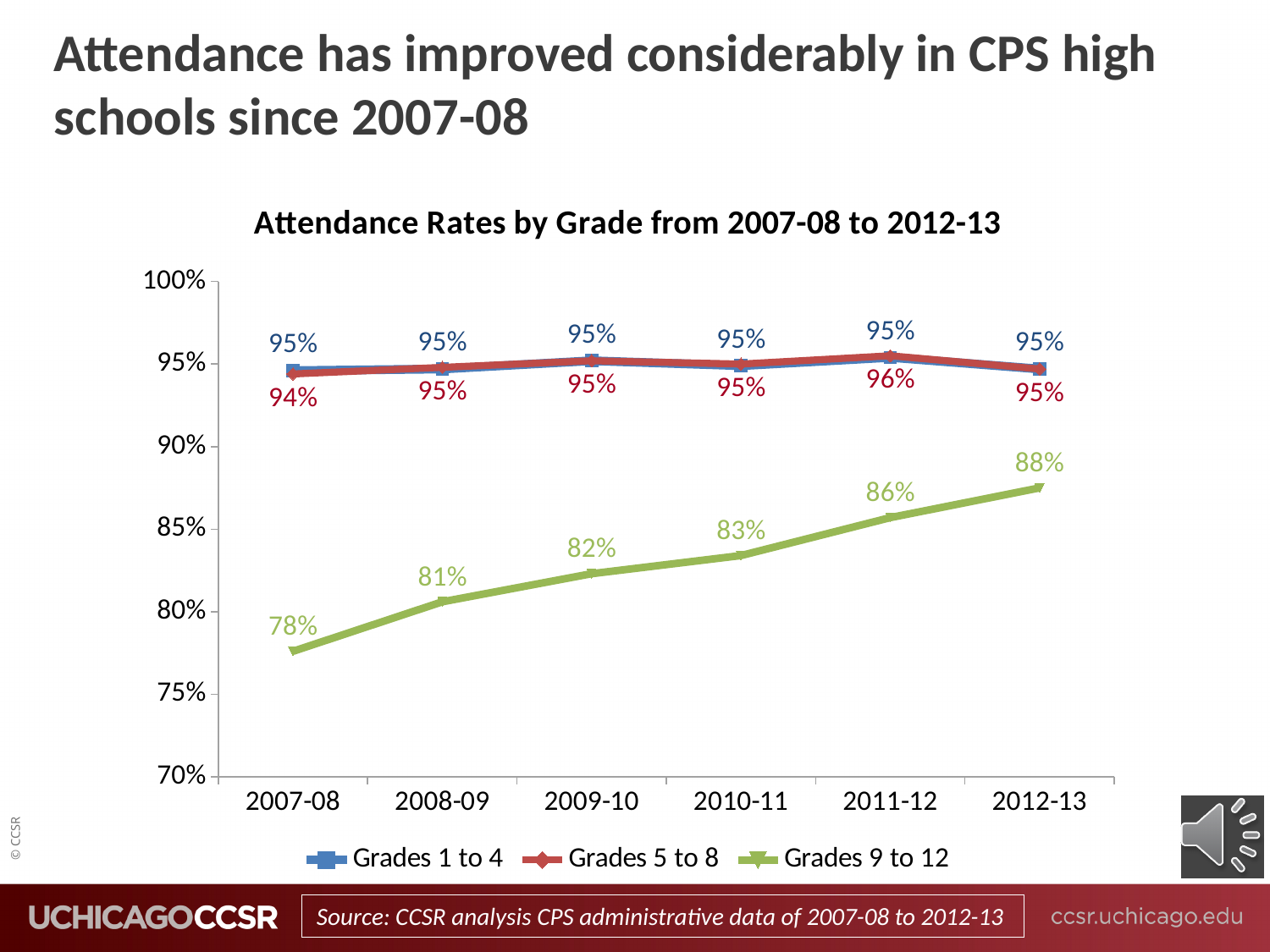
How many series does the legend list? 3 What is the attendance rate for Grades 9 to 12 in 2007-08? 78% Is the attendance rate for Grades 9 to 12 in 2008-09 greater or less than 85%? less In which year is the attendance rate for Grades 9 to 12 highest? 2012-13 How many school years are shown on the x axis? 6 In which year is the attendance rate for Grades 9 to 12 lowest? 2007-08 Which series has the higher attendance rate in 2009-10: Grades 1 to 4 or Grades 9 to 12? Grades 1 to 4 What is the attendance rate for Grades 9 to 12 in 2012-13? 88% What is the difference between the Grades 9 to 12 attendance rate in 2012-13 and in 2007-08? 10% What kind of chart is shown on the slide? line chart What is the attendance rate for Grades 5 to 8 in 2011-12? 96% What is the attendance rate for Grades 1 to 4 in 2010-11? 95%